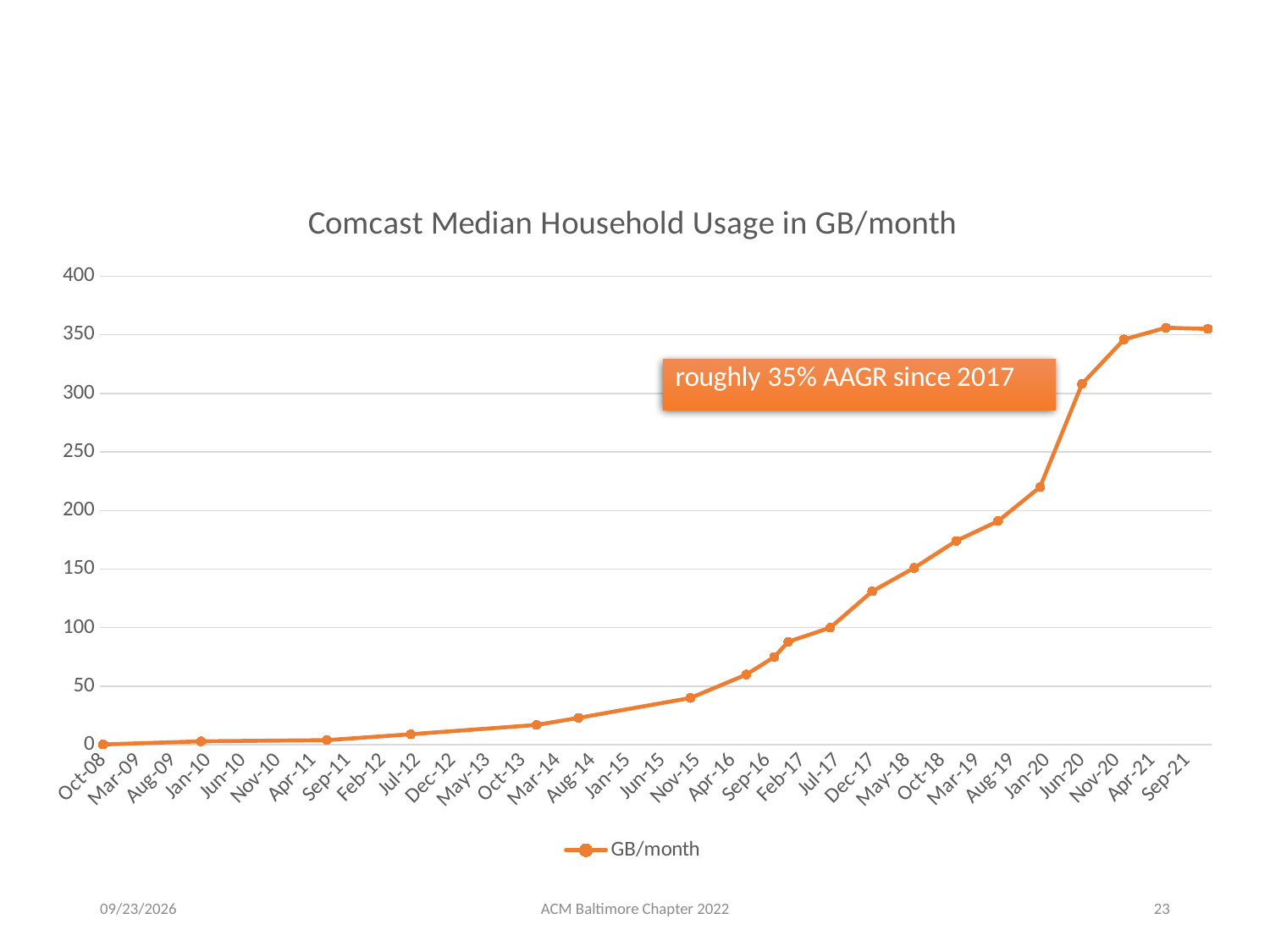
Which is larger, the value for Jun-20 or the value for Jan-20? Jun-20 Is the value for Nov-15 greater or less than 50? less Which point on the x axis has the lowest value? Oct-08 How many series does the legend list? 1 Is the value for Jan-20 greater or less than 200? greater What is the name of the series shown in the legend? GB/month What is the title of the chart? Comcast Median Household Usage in GB/month Is the value for Jun-20 greater or less than 300? greater Do the values generally rise or fall from Oct-08 to Sep-21? rise What kind of chart is shown on the slide? line chart